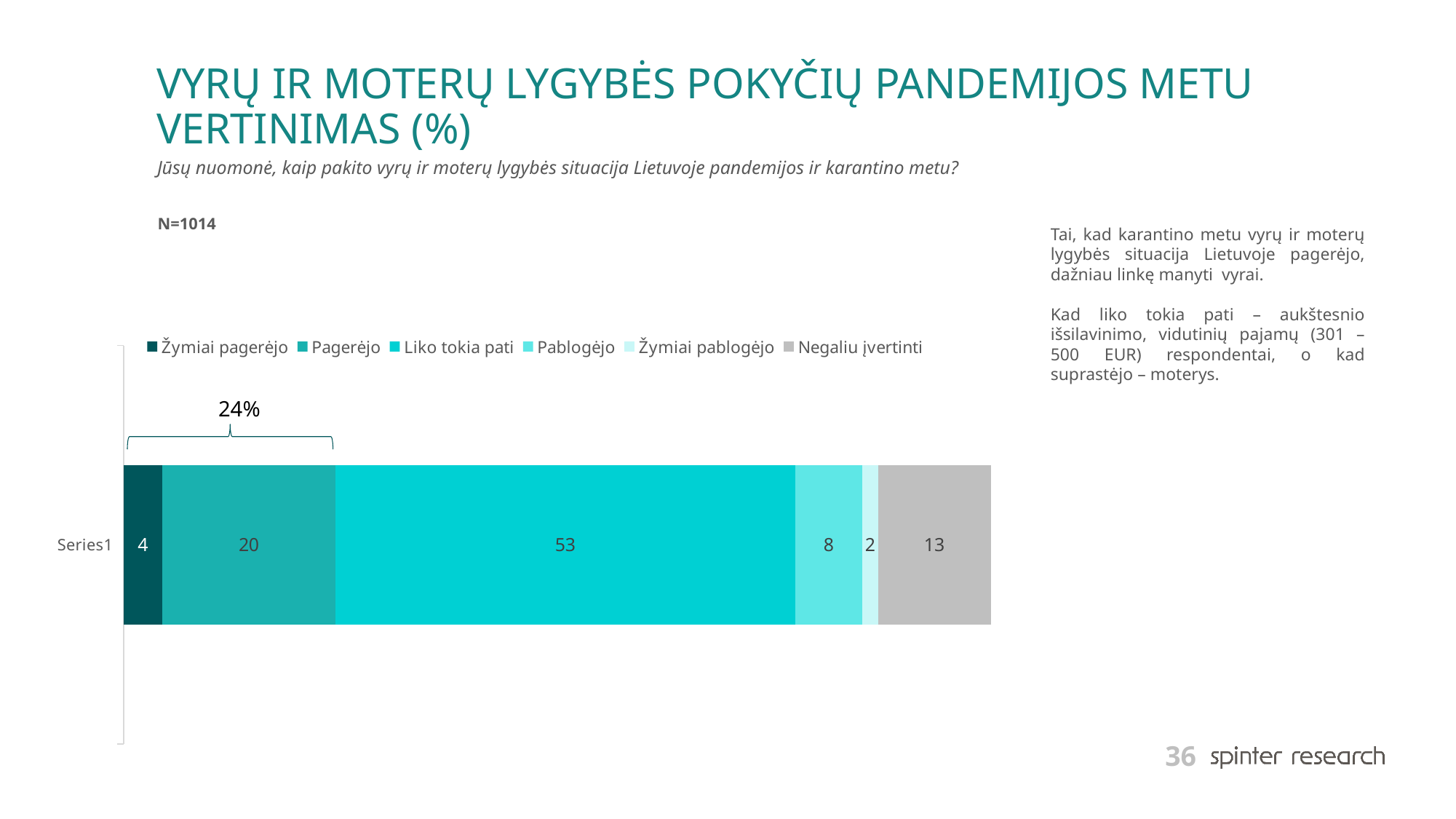
What is the value for "Pagerėjo"? 20 How many series does the legend list? 6 What is the value for "Negaliu įvertinti"? 13 Which segment of the bar has the highest value? Liko tokia pati What is the value for "Žymiai pablogėjo"? 2 What is the difference between the values for "Liko tokia pati" and "Pagerėjo"? 33 What is the value for "Liko tokia pati"? 53 What is the total of all segments in the stacked bar? 100 What percentage is shown by the bracket above the first two segments of the bar? 24% What kind of chart is shown on the slide? Stacked bar chart Which is larger, the value for "Pablogėjo" or the value for "Negaliu įvertinti"? Negaliu įvertinti Which segment of the bar has the lowest value? Žymiai pablogėjo